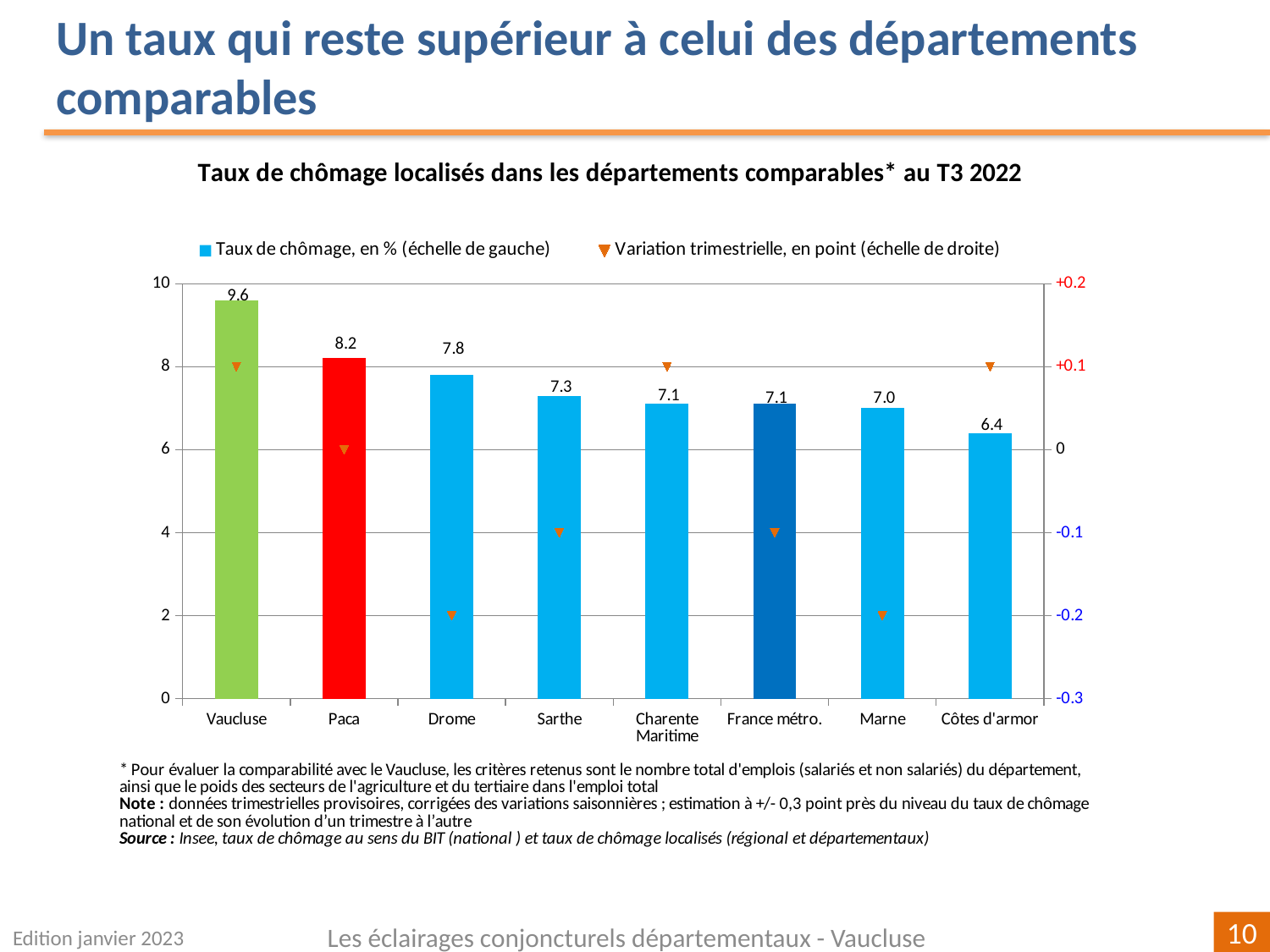
What is the quarterly variation (variation trimestrielle) shown for Drome on the right-hand axis? -0.2 What kind of chart is used to show the unemployment rates? Bar chart Which category has the highest unemployment rate? Vaucluse What is the quarterly variation shown for Vaucluse on the right-hand axis? +0.1 What is the difference between the unemployment rate of Vaucluse and that of France métro.? 2.5 What is the unemployment rate shown for Côtes d'armor? 6.4 How many series does the legend list? 2 What is the unemployment rate (taux de chômage) shown for Vaucluse? 9.6 Which has a higher unemployment rate, Paca or Drome? Paca What is the unemployment rate shown for Sarthe? 7.3 Which category has the lowest unemployment rate? Côtes d'armor How many categories are shown on the x axis? 8